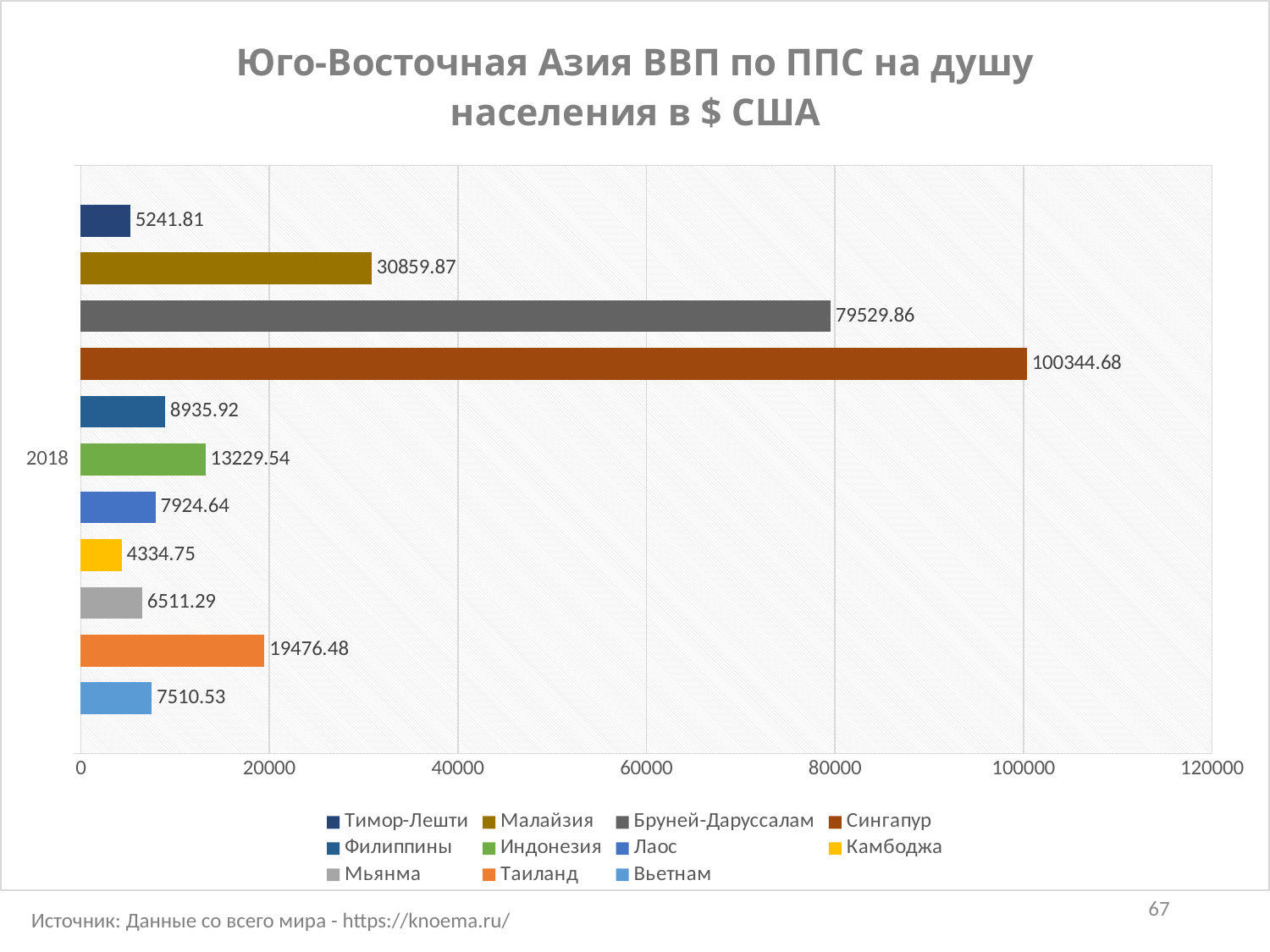
What is the value for Малайзия? 30859.87 What is the difference between the values for Сингапур and Бруней-Даруссалам? 20814.82 What is the value for Индонезия? 13229.54 What is the value for Сингапур? 100344.68 Is the value for Бруней-Даруссалам greater or less than 60000? greater Which country has the lowest value? Камбоджа Which is larger, the value for Филиппины or the value for Лаос? Филиппины What is the value for Вьетнам? 7510.53 How many series does the legend list? 11 What kind of chart is shown on the slide? bar chart What is the difference between the values for Малайзия and Таиланд? 11383.39 Which country has the highest value? Сингапур